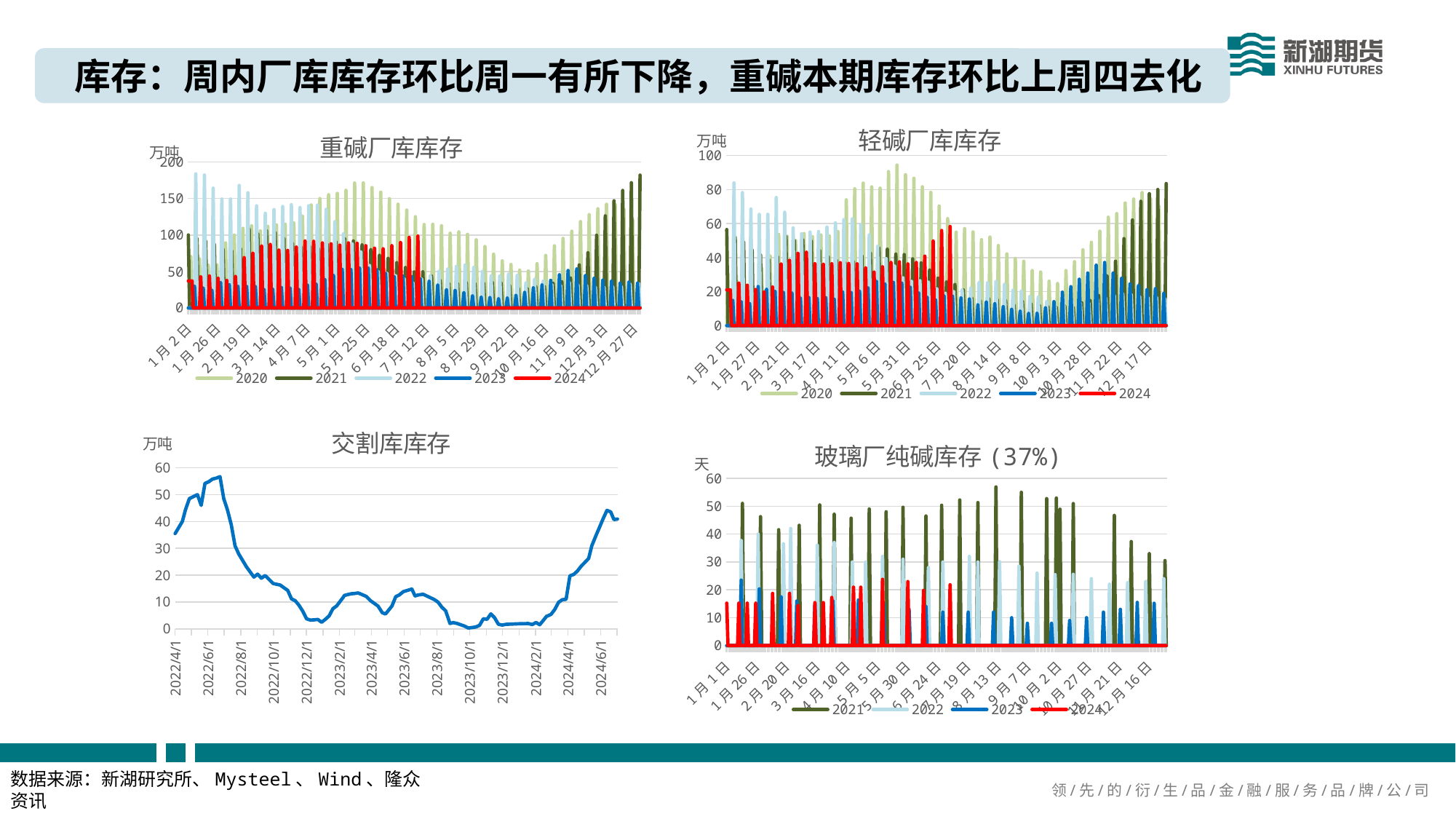
What kind of chart is the 重碱厂库库存 chart? line chart What unit is shown on the y axis of the 玻璃厂纯碱库存（37%） chart? 天 In the 轻碱厂库库存 chart, is the highest value of the 2020 series greater or less than 80? greater What kind of chart is the 交割库库存 chart? line chart In the 交割库库存 chart, does the value rise or fall between 2022/6/1 and 2022/12/1? fall In the 交割库库存 chart, is the value around 2023/10/1 greater or less than 10? less In the 重碱厂库库存 chart, is the highest value of the 2022 series greater or less than 150? greater How many series does the legend of the 玻璃厂纯碱库存（37%） chart list? 4 In the 交割库库存 chart, does the value rise or fall between 2024/2/1 and 2024/6/1? rise How many series does the legend of the 重碱厂库库存 chart list? 5 Which series in the 重碱厂库库存 chart is drawn in red? 2024